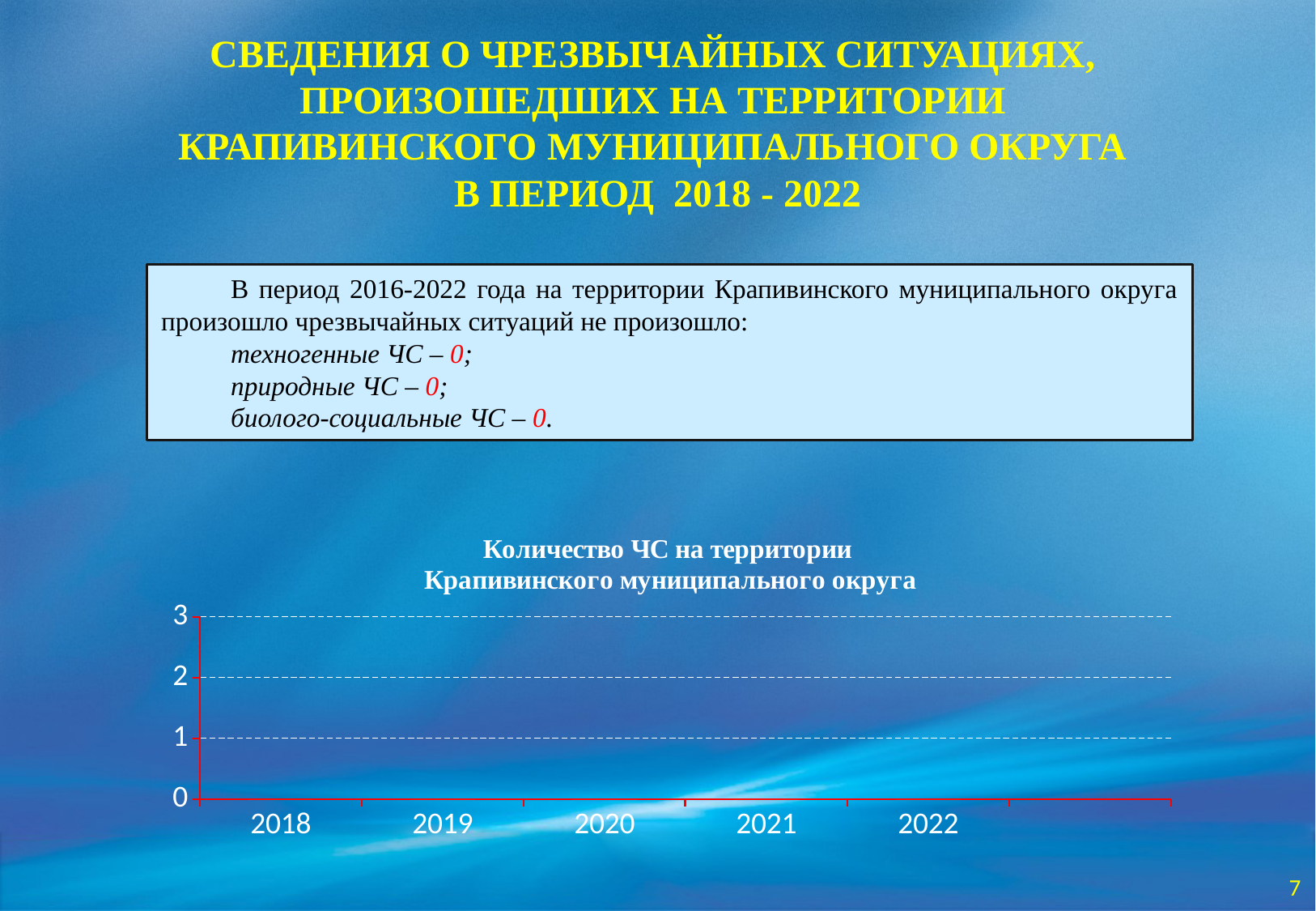
What is the title of the chart? Количество ЧС на территории Крапивинского муниципального округа Is the value for 2020 greater or less than 1? less How many categories are shown on the x axis of the chart? 5 Is the value for 2018 greater or less than 1? less Is the value for 2022 greater or less than 2? less What is the highest value shown on the chart's y axis? 3 Which year is the first category on the x axis of the chart? 2018